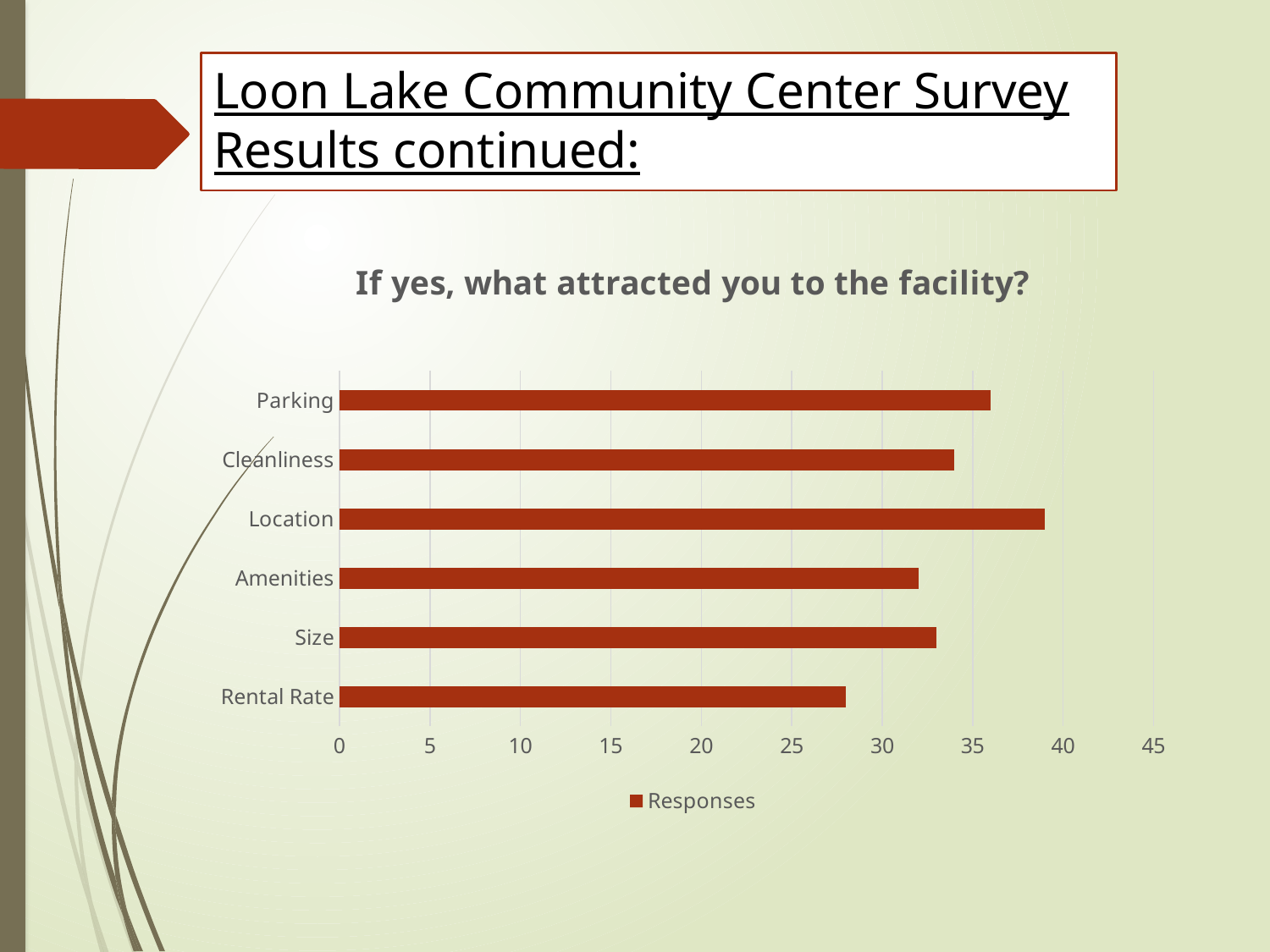
What is the title of the chart? If yes, what attracted you to the facility? How many categories are shown in the chart? 6 Which category has the highest number of responses? Location How many series does the legend list? 1 Which category has the lowest number of responses? Rental Rate Is the value for Rental Rate greater or less than 30? less Is the value for Amenities greater or less than 30? greater What series name is shown in the legend? Responses Which has more responses, Rental Rate or Size? Size Is the value for Location greater or less than 35? greater What kind of chart is shown on the slide? bar chart Which has more responses, Parking or Cleanliness? Parking